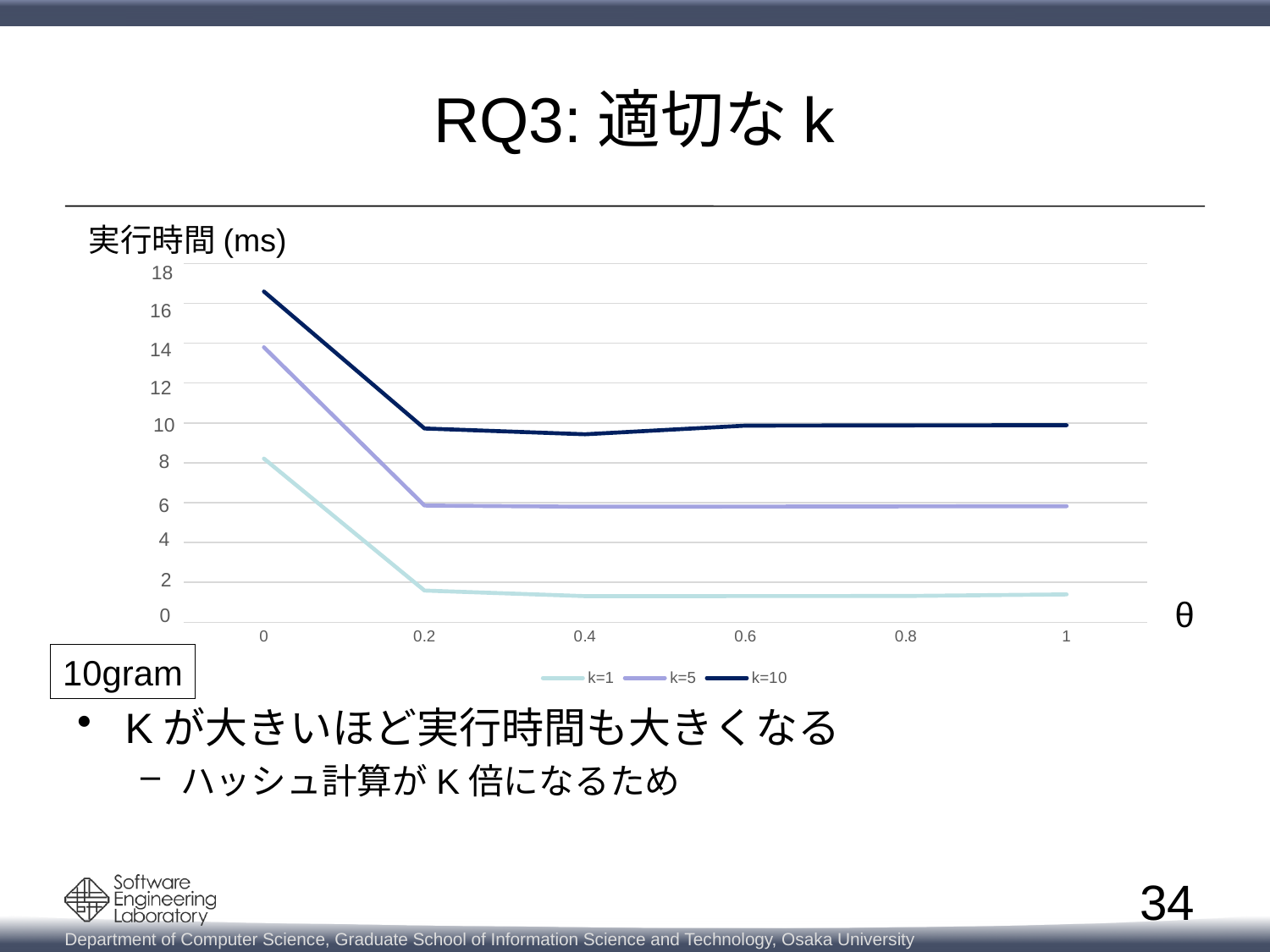
How many θ values are marked on the x axis? 6 Which series has the highest value at θ=0.6? k=10 Is the value for k=5 at θ=0 greater or less than 12? greater Is the value for k=1 at θ=0.2 greater or less than 2? less Is the value for k=10 at θ=1 greater or less than 8? greater Which series has the lowest values across the whole chart? k=1 What is the label on the y axis of the chart? 実行時間 (ms) At θ=0, which series has the larger value, k=10 or k=1? k=10 Does the value for k=1 rise or fall from θ=0 to θ=0.2? fall How many series does the legend list? 3 What kind of chart is shown on the slide? line chart